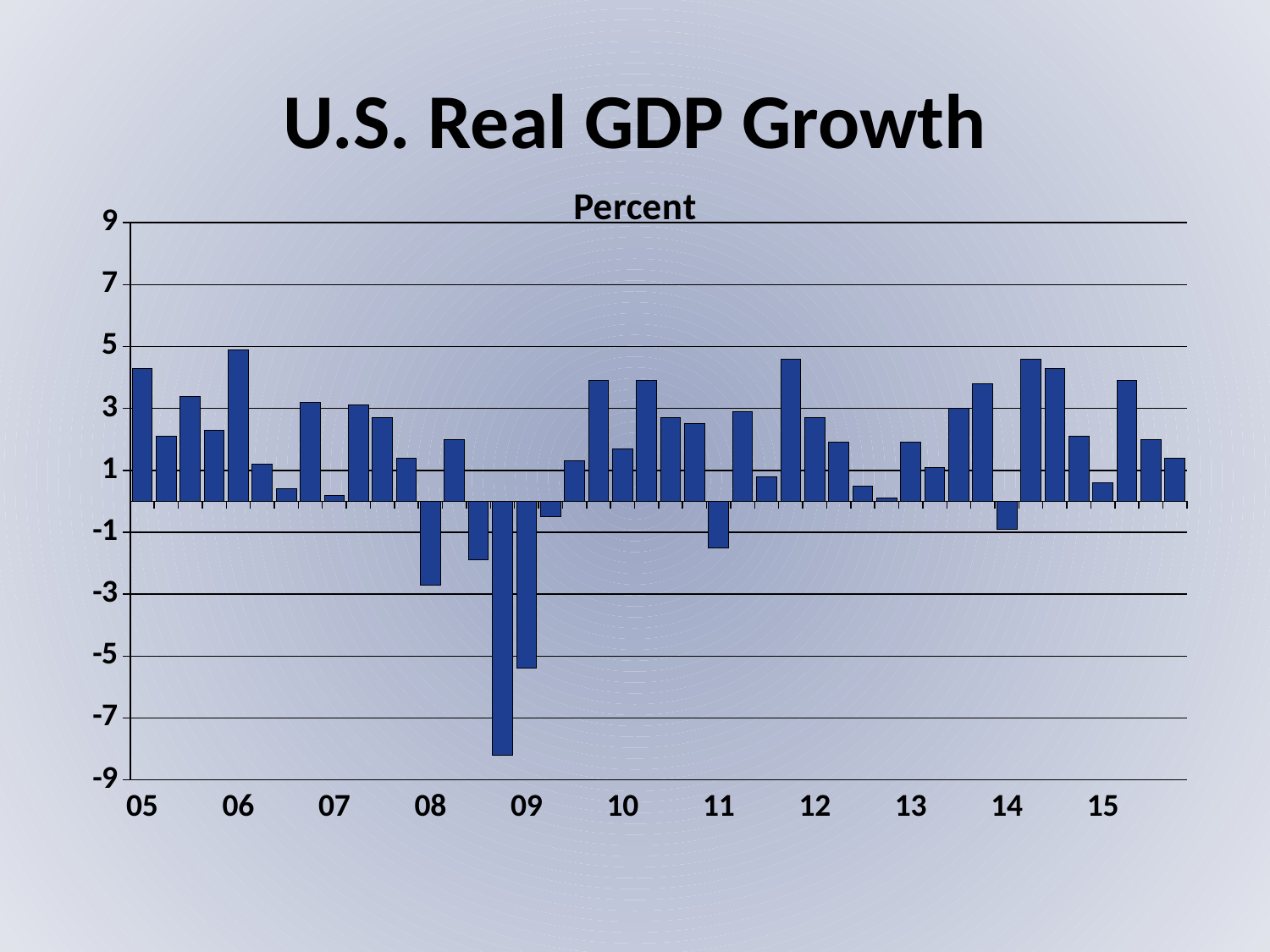
What kind of chart is shown on the slide? bar chart How many year labels are shown along the x axis? 11 Is the value of the bar at the 06 label greater or less than 3? greater Is the lowest value on the chart greater or less than -7? less Is the value of the bar at the 14 label greater or less than 0? less Which is larger, the bar at the 06 label or the bar at the 08 label? 06 What is the highest value shown on the vertical axis? 9 What is the title of the chart? U.S. Real GDP Growth Which is larger, the bar at the 08 label or the bar at the 09 label? 08 What unit label is shown above the vertical axis? Percent